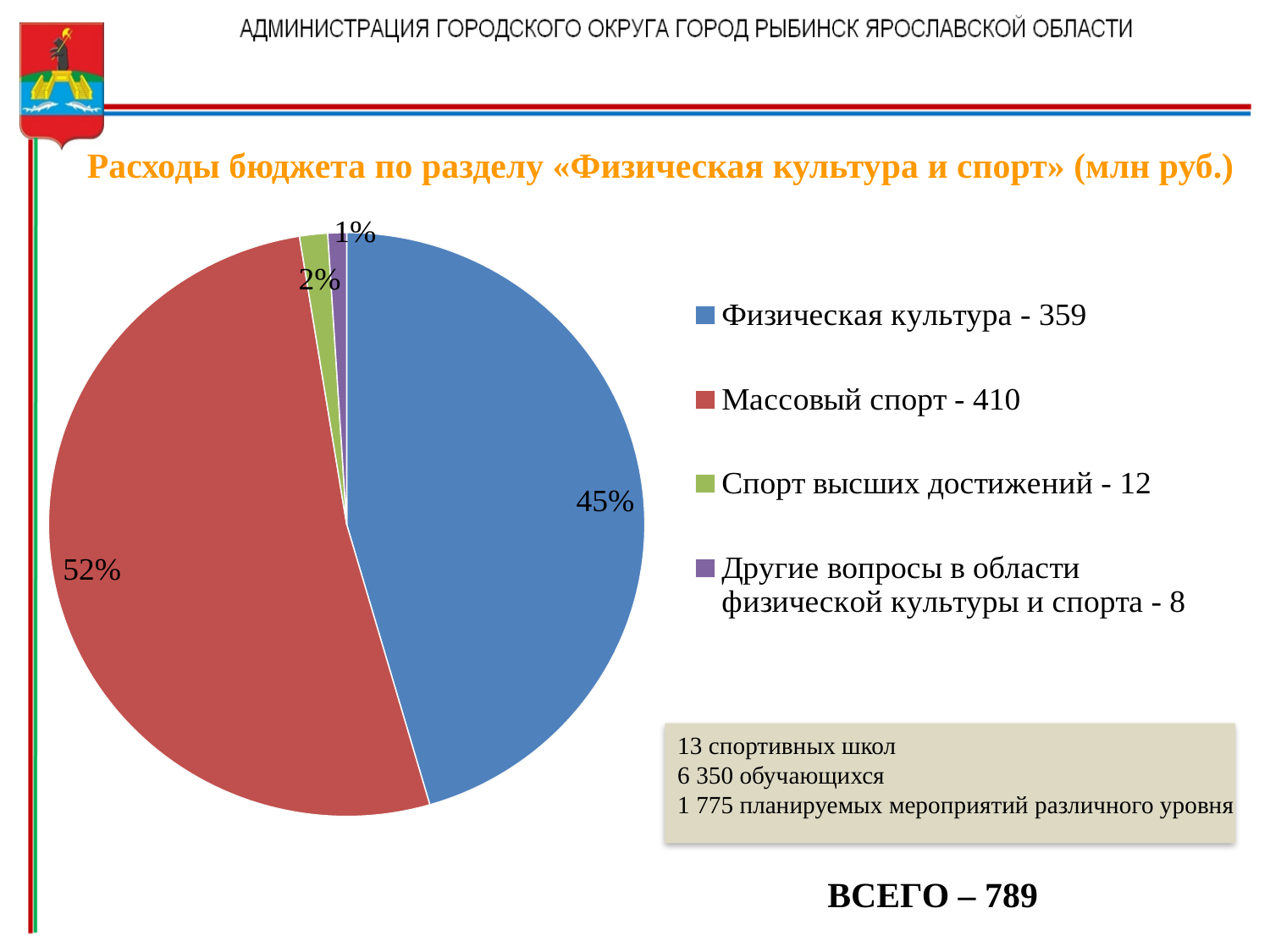
Which category has the smallest slice of the pie? Другие вопросы в области физической культуры и спорта How many entries does the legend of the pie chart list? 4 What is the difference between the values for Массовый спорт and Физическая культура? 51 What percentage share of the pie is labelled for Массовый спорт? 52% What percentage share of the pie is labelled for Физическая культура? 45% What value (млн руб.) does the legend give for Массовый спорт? 410 What value (млн руб.) does the legend give for Другие вопросы в области физической культуры и спорта? 8 Which category has the largest slice of the pie? Массовый спорт How many slices does the pie chart have? 4 What kind of chart is shown on the slide? pie chart What is the total (ВСЕГО) of all categories shown on the slide? 789 What percentage share of the pie is labelled for Спорт высших достижений? 2%